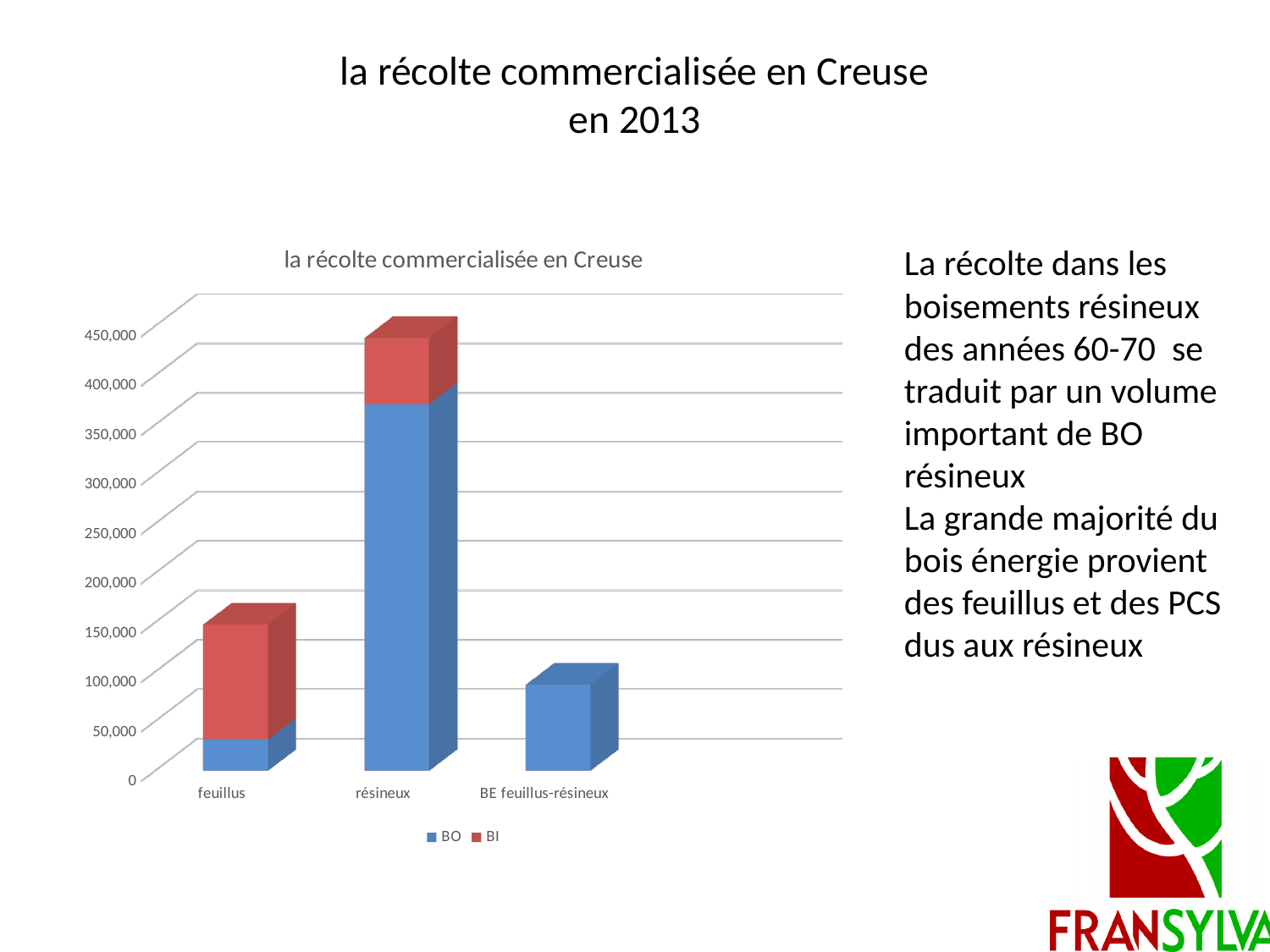
How many series does the chart legend list? 2 Is the BO value for résineux greater or less than 350,000? greater Which is larger, the BI value for feuillus or the BI value for résineux? feuillus Which category has the highest total bar in the chart? résineux What is the title of the chart? la récolte commercialisée en Creuse How many categories are shown on the x axis of the chart? 3 Is the BO value for feuillus greater or less than 50,000? less What kind of chart is shown on the slide? bar chart Which category has the lowest total bar in the chart? BE feuillus-résineux Which is larger, the BO value for résineux or the BO value for feuillus? résineux Is the BO value for BE feuillus-résineux greater or less than 50,000? greater